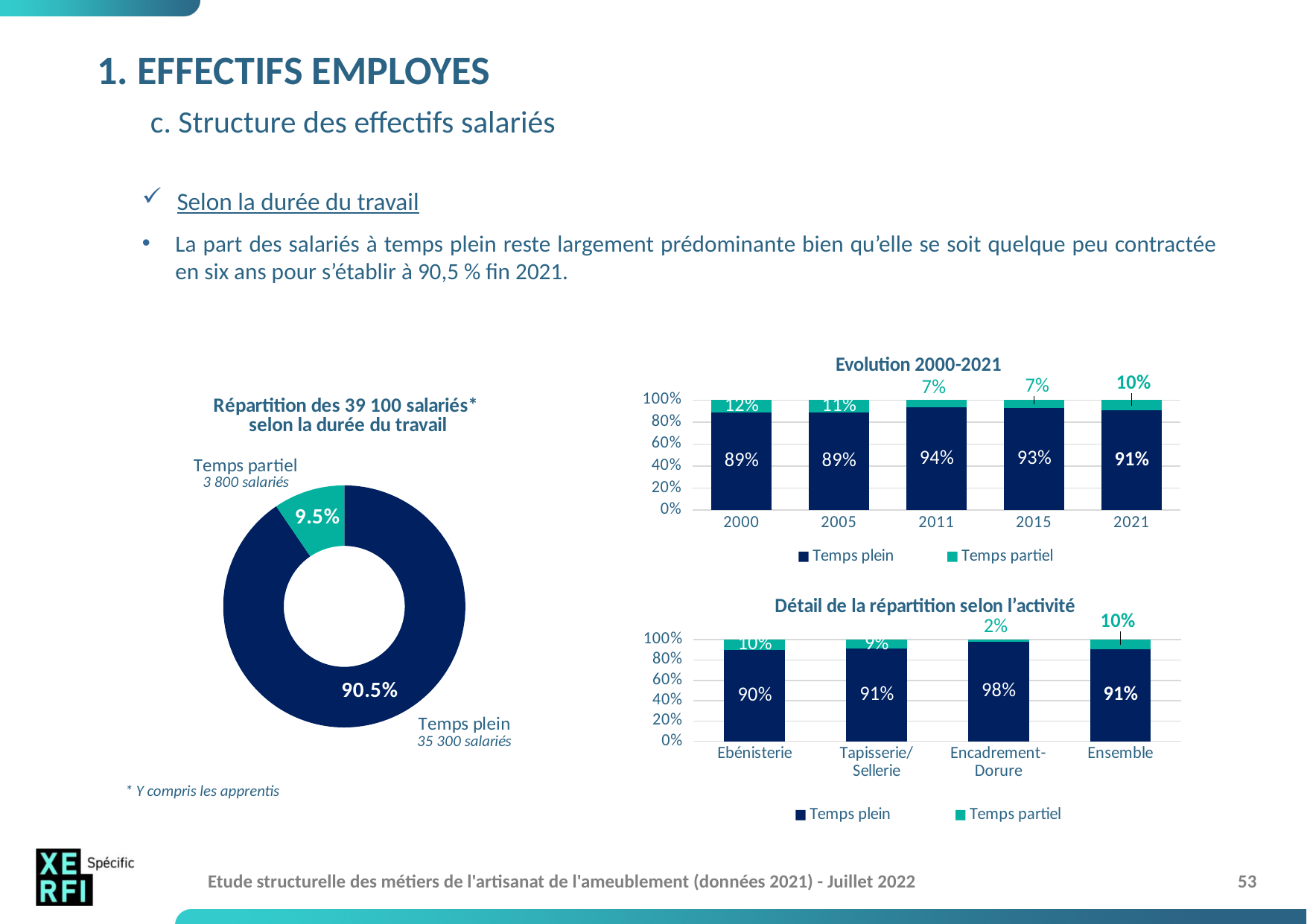
In the chart 'Evolution 2000-2021', which year has the highest 'Temps plein' value? 2011 In the chart 'Evolution 2000-2021', what is the difference between the 'Temps plein' values for 2011 and 2021? 3 percentage points What kind of chart is 'Répartition des 39 100 salariés selon la durée du travail'? Pie (donut) chart How many series does the legend of the chart 'Détail de la répartition selon l'activité' list? 2 In the chart 'Détail de la répartition selon l'activité', is the 'Temps plein' value for 'Ebénisterie' or for 'Tapisserie/Sellerie' larger? Tapisserie/Sellerie In the chart 'Détail de la répartition selon l'activité', which activity has the lowest 'Temps partiel' value? Encadrement-Dorure In the chart 'Evolution 2000-2021', how many years are shown on the x axis? 5 In the chart 'Evolution 2000-2021', what is the 'Temps partiel' value for 2000? 12% In the chart 'Répartition des 39 100 salariés selon la durée du travail', what share of employees are 'Temps plein'? 90.5% In the chart 'Répartition des 39 100 salariés selon la durée du travail', what share of employees are 'Temps partiel'? 9.5% In the chart 'Evolution 2000-2021', what is the 'Temps plein' value for 2011? 94% In the chart 'Détail de la répartition selon l'activité', what is the 'Temps plein' value for 'Encadrement-Dorure'? 98%